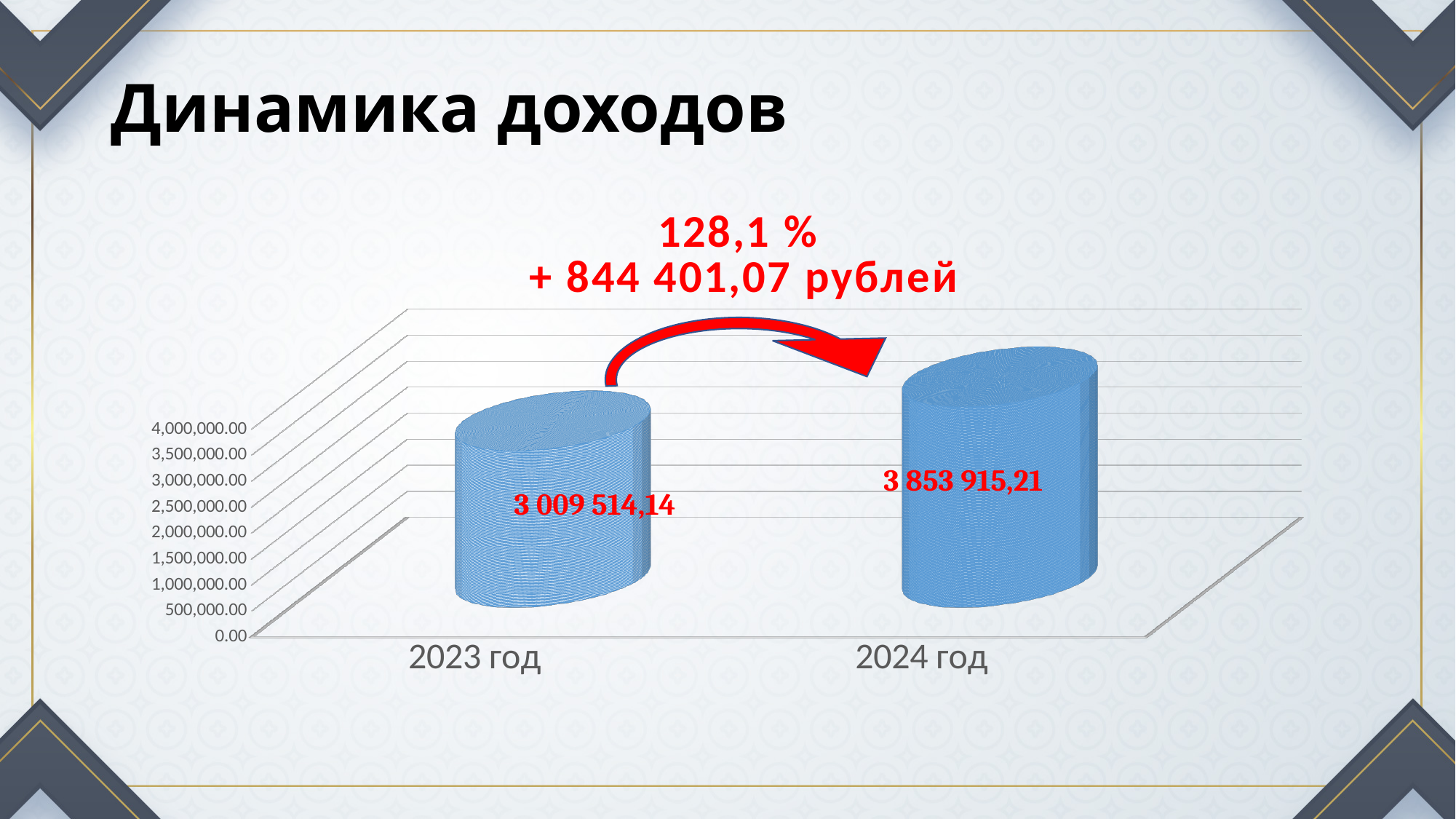
Which year has the higher value? 2024 год What is the title of the slide? Динамика доходов What is the value for 2024 год? 3 853 915,21 What kind of chart is shown? bar chart How many categories are shown on the x axis? 2 Is the value for 2023 год greater or less than 3,500,000.00? less What is the value for 2023 год? 3 009 514,14 Which year has the lower value? 2023 год Do the values rise or fall from 2023 год to 2024 год? rise Is the value for 2024 год greater or less than 3,500,000.00? greater Is the value for 2023 год larger or smaller than the value for 2024 год? smaller What is the difference between the 2024 год and 2023 год values? 844 401,07